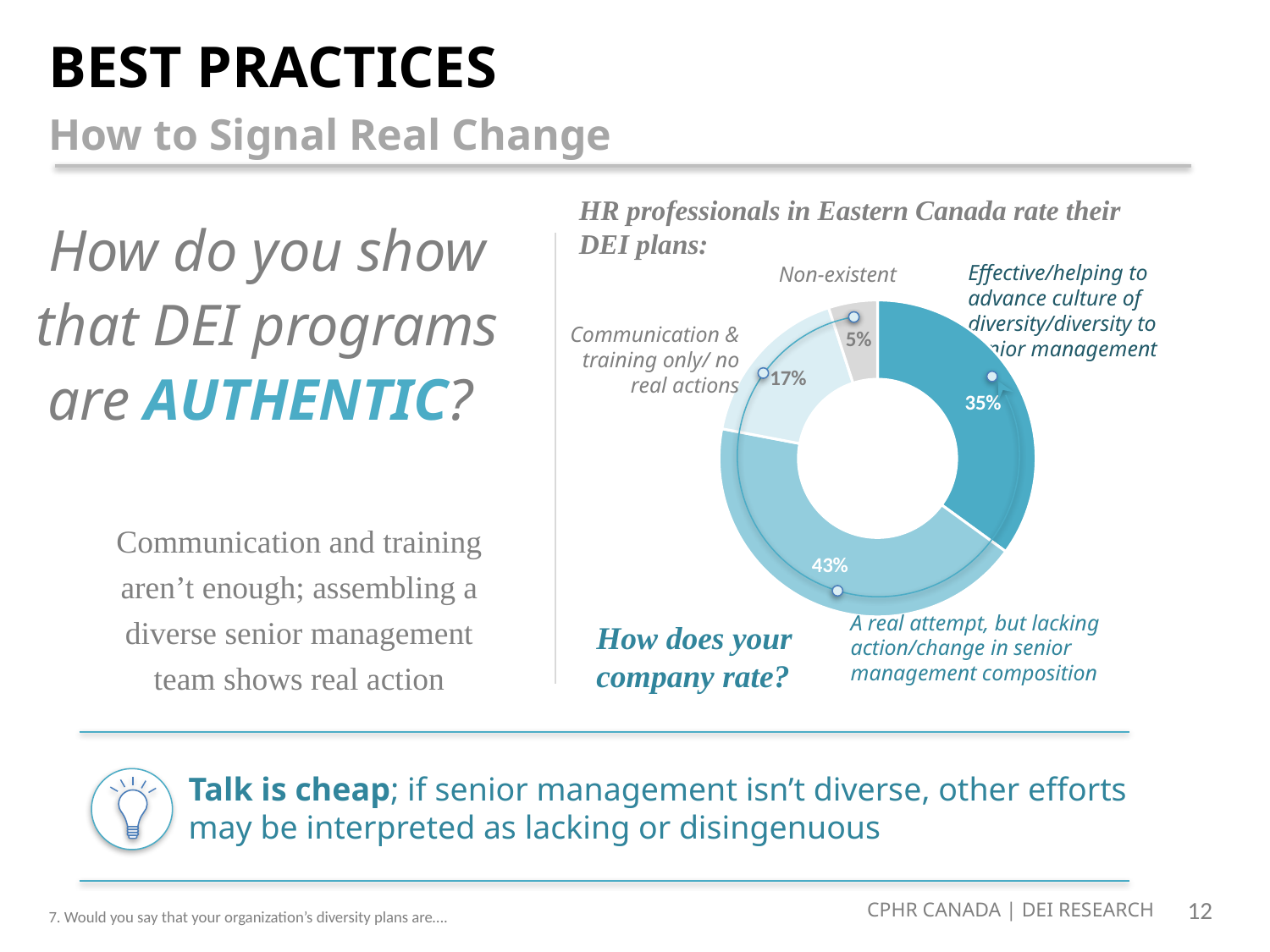
What is the difference in percentage points between 'A real attempt, but lacking action/change in senior management composition' and 'Effective/helping to advance culture of diversity/diversity to senior management'? 8 percentage points Which rating category has the smallest share of the chart? Non-existent Which rating category has the largest share of the chart? A real attempt, but lacking action/change in senior management composition What percentage of HR professionals rated their DEI plans as 'Non-existent'? 5% What kind of chart is shown on the slide? Donut (pie) chart What percentage of HR professionals rated their DEI plans as 'Communication & training only/ no real actions'? 17% What percentage of HR professionals rated their DEI plans as 'A real attempt, but lacking action/change in senior management composition'? 43% Which is larger: the share for 'Communication & training only/ no real actions' or the share for 'Non-existent'? Communication & training only/ no real actions What is the title of the chart? HR professionals in Eastern Canada rate their DEI plans: What is the combined share of 'Communication & training only/ no real actions' and 'Non-existent'? 22% What percentage of HR professionals rated their DEI plans as 'Effective/helping to advance culture of diversity/diversity to senior management'? 35% How many rating categories are shown in the chart? 4